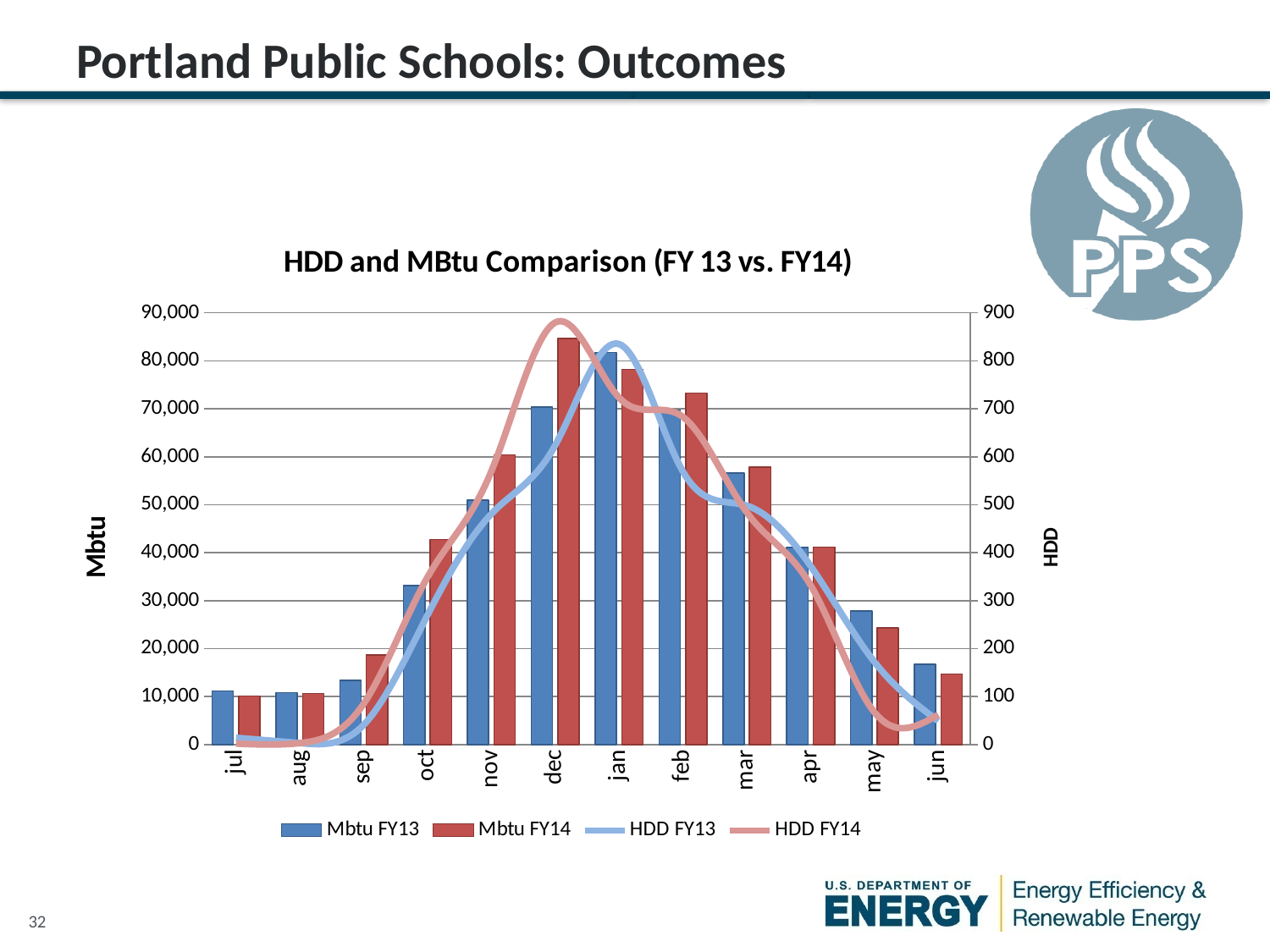
How many months are shown along the x axis? 12 How many series does the legend list? 4 Do the Mbtu FY13 bars rise or fall from jan to jun? fall What label is on the right-hand vertical axis? HDD Is the Mbtu FY14 value for may greater or less than 30,000? less Is the Mbtu FY13 value for oct greater or less than 40,000? less What is the title of the chart? HDD and MBtu Comparison (FY 13 vs. FY14) In which month is the Mbtu FY13 bar highest? jan What kind of chart is shown on the slide? A combined bar and line chart In dec, which is larger: Mbtu FY13 or Mbtu FY14? Mbtu FY14 In which month is the Mbtu FY14 bar highest? dec Is the Mbtu FY14 value for dec greater or less than 80,000? greater